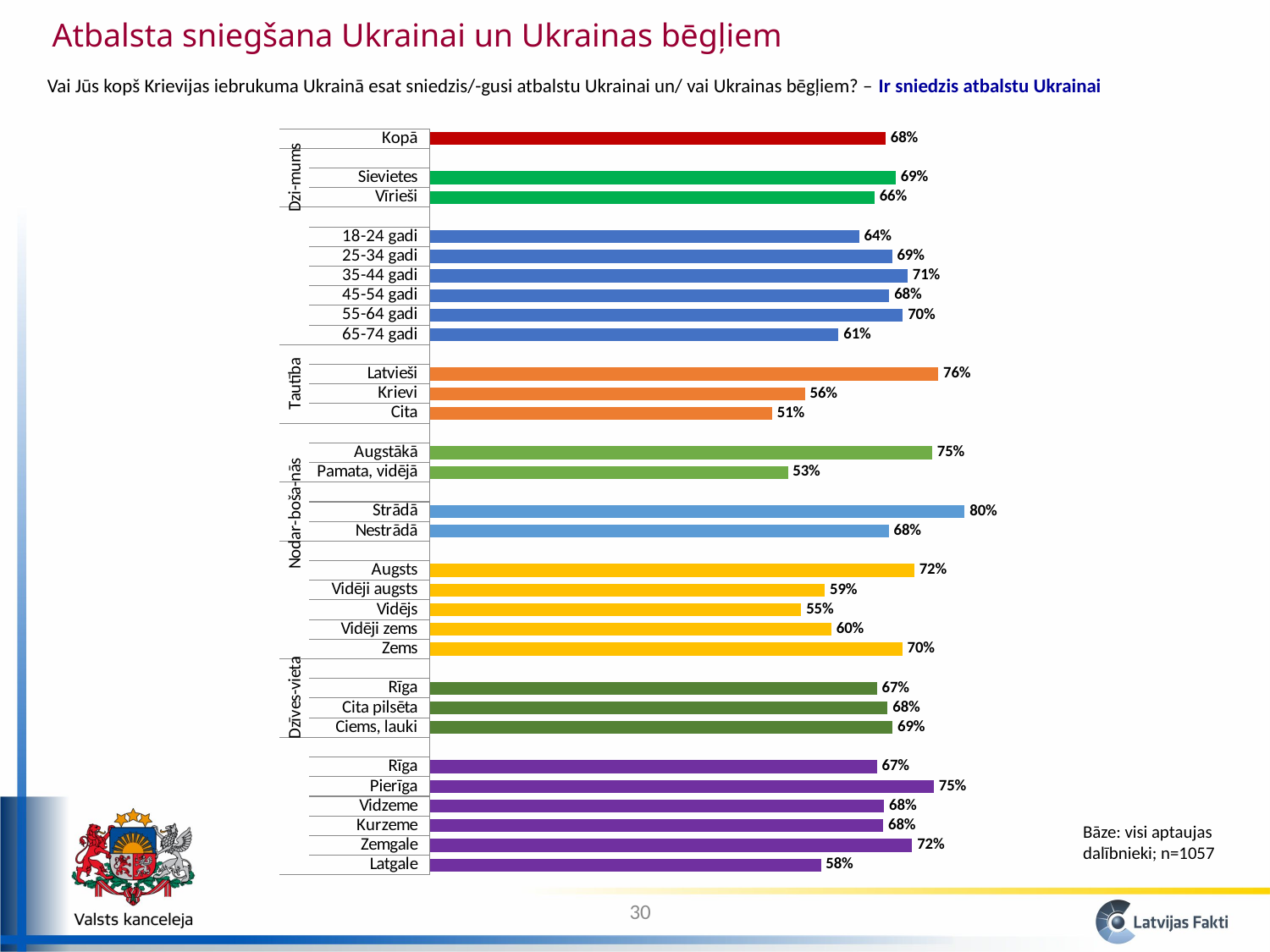
What is the value for Latvieši? 76% What is the value for Latgale? 58% What kind of chart is shown on the slide? Bar chart What is the difference between the values for Sievietes and Vīrieši? 3% What is the value for Kopā? 68% Which is larger, the value for 35-44 gadi or the value for 65-74 gadi? 35-44 gadi Which category has the highest value? Strādā Which category has the lowest value? Cita How many bars are plotted in the chart? 30 What is the difference between the values for Latvieši and Krievi? 20% What is the value for Pamata, vidējā? 53% Which is larger, the value for Augstākā or the value for Pierīga? They are equal (75%)